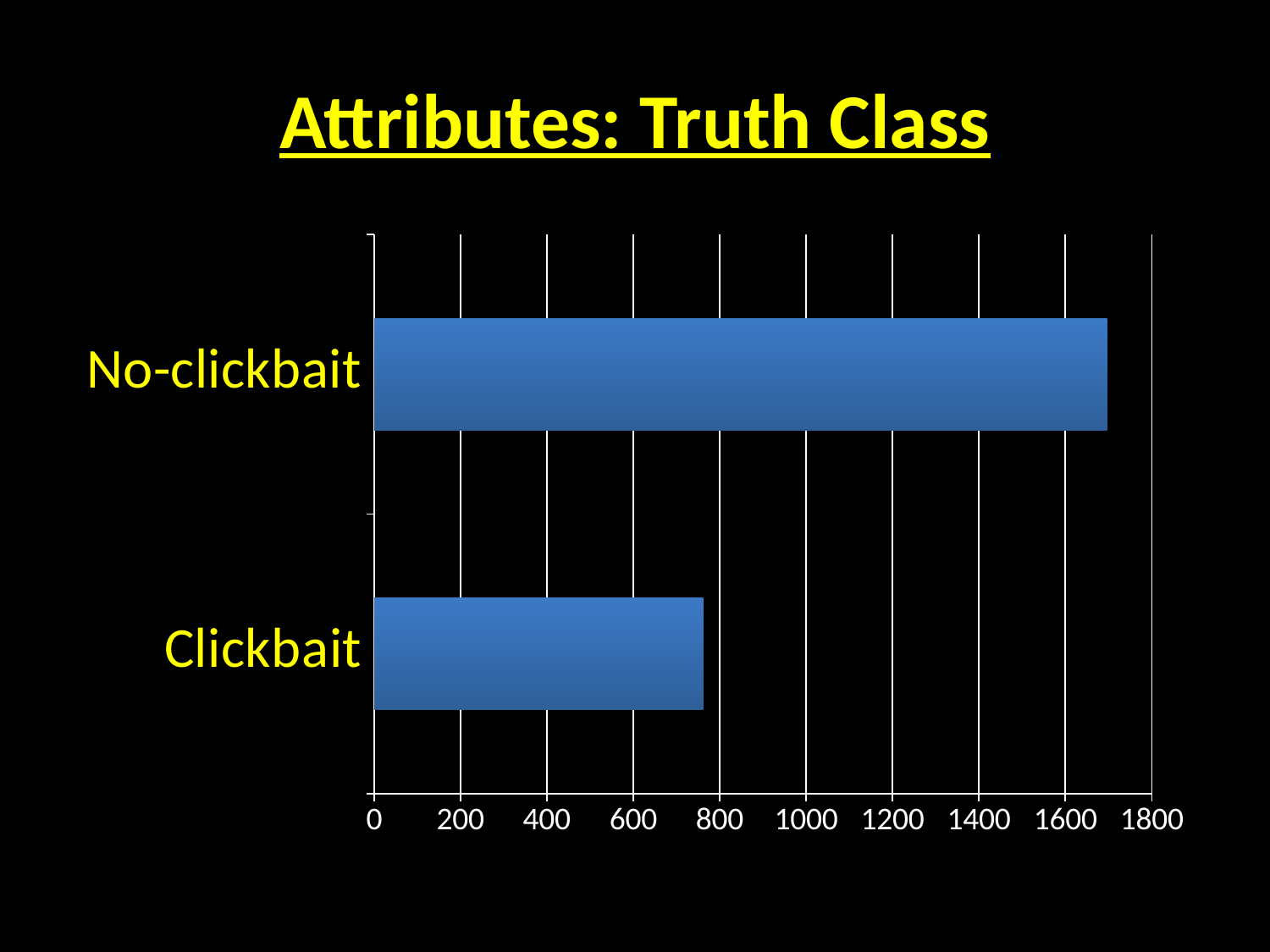
What is the title of the slide containing the chart? Attributes: Truth Class Which category has the highest value? No-clickbait Is the value for Clickbait greater or less than 600? greater What kind of chart is shown on the slide? bar chart Which category has the lowest value? Clickbait How many categories are plotted in the chart? 2 Is the value for No-clickbait greater or less than 1800? less Is the value for Clickbait greater or less than 800? less What is the maximum value shown on the horizontal axis? 1800 Which is larger, the value for No-clickbait or the value for Clickbait? No-clickbait